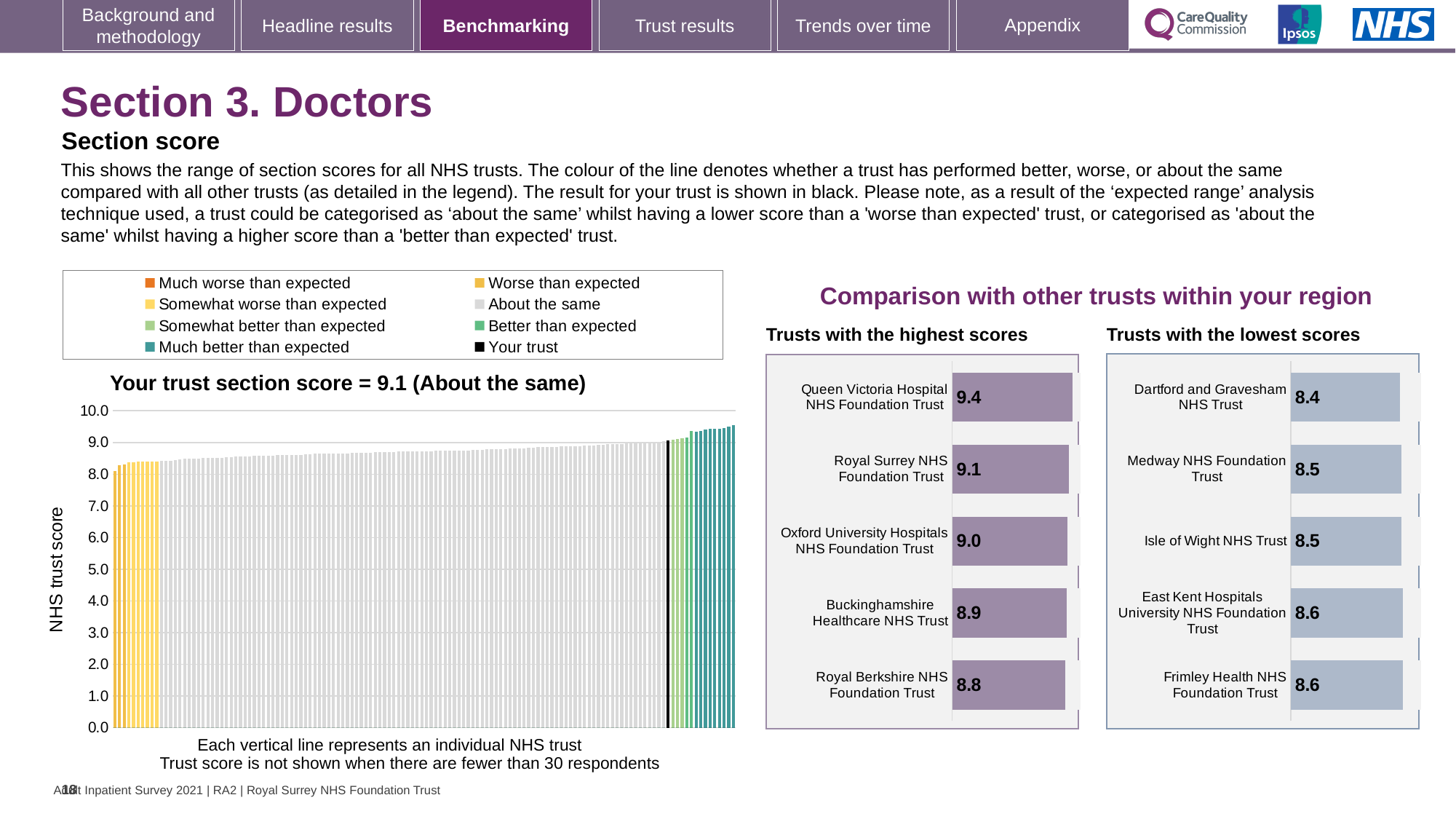
In the 'Trusts with the lowest scores' chart, what is the score for East Kent Hospitals University NHS Foundation Trust? 8.6 In the 'Trusts with the highest scores' chart, what is the difference between the scores of Queen Victoria Hospital NHS Foundation Trust and Royal Surrey NHS Foundation Trust? 0.3 In the 'Trusts with the highest scores' chart, what is the score for Queen Victoria Hospital NHS Foundation Trust? 9.4 What kind of chart is the main chart on the left showing all NHS trusts? Bar chart In the 'Trusts with the lowest scores' chart, which trust has the lowest score? Dartford and Gravesham NHS Trust In the 'Trusts with the highest scores' chart, how many trusts are shown? 5 In the main chart on the left, what is your trust's section score? 9.1 In the 'Trusts with the lowest scores' chart, what is the score for Dartford and Gravesham NHS Trust? 8.4 In the main chart on the left, do the trust scores rise or fall from left to right along the x axis? Rise In the 'Trusts with the highest scores' chart, which trust has the highest score? Queen Victoria Hospital NHS Foundation Trust In the 'Trusts with the highest scores' chart, what is the score for Royal Berkshire NHS Foundation Trust? 8.8 In the 'Trusts with the lowest scores' chart, which has the larger score: Medway NHS Foundation Trust or Frimley Health NHS Foundation Trust? Frimley Health NHS Foundation Trust